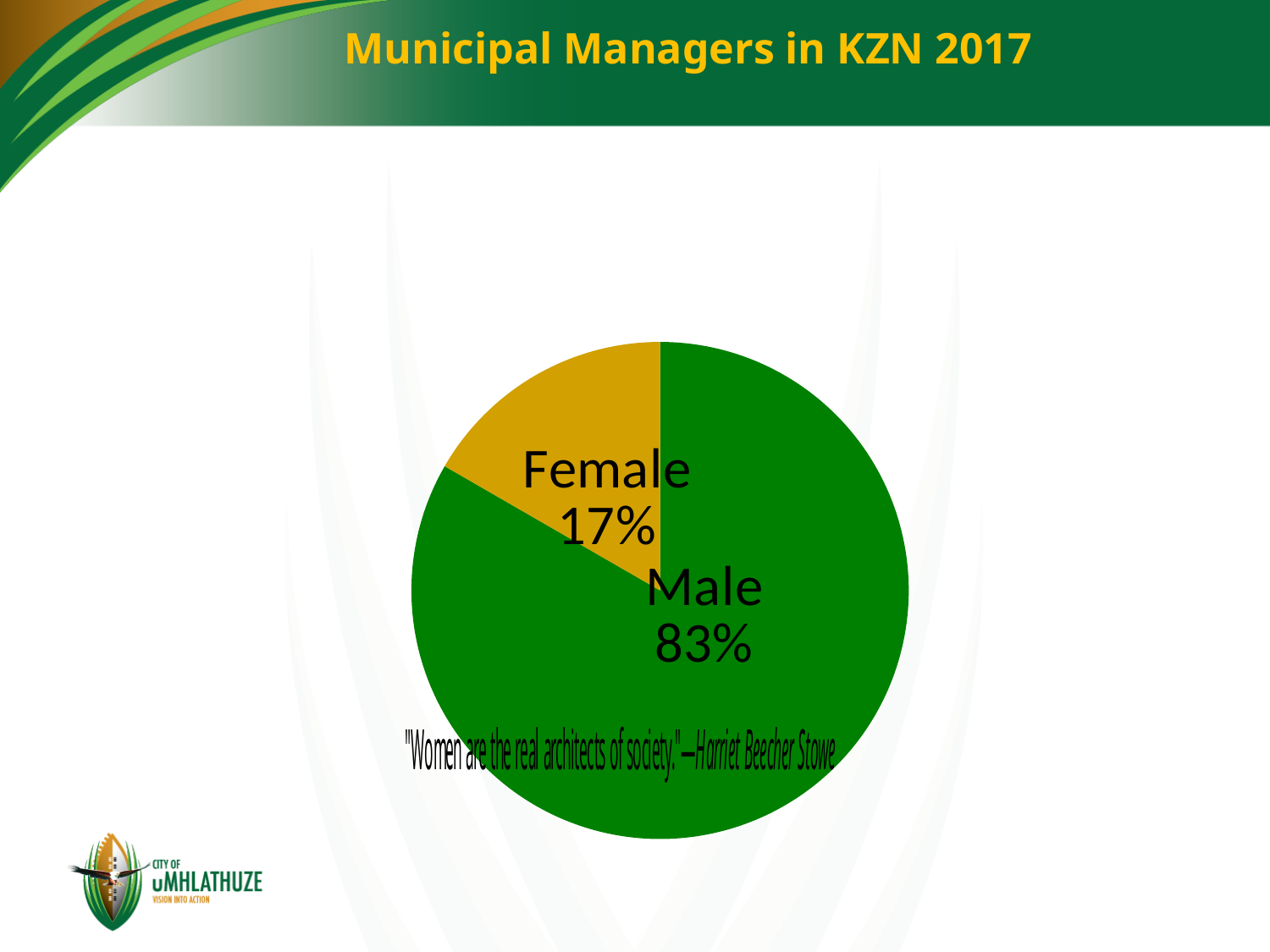
What is the title of the slide containing the pie chart? Municipal Managers in KZN 2017 How many slices does the pie chart have? 2 What kind of chart is shown on the slide? pie chart Which category has the smallest slice of the pie? Female What share of municipal managers in KZN in 2017 are female? 17% What is the difference in percentage points between the Male and Female slices? 66 Is the Female share greater or less than 50%? less Which slice is larger, Male or Female? Male What share of municipal managers in KZN in 2017 are male? 83% Which category has the largest slice of the pie? Male What colour is the Female slice of the pie? gold